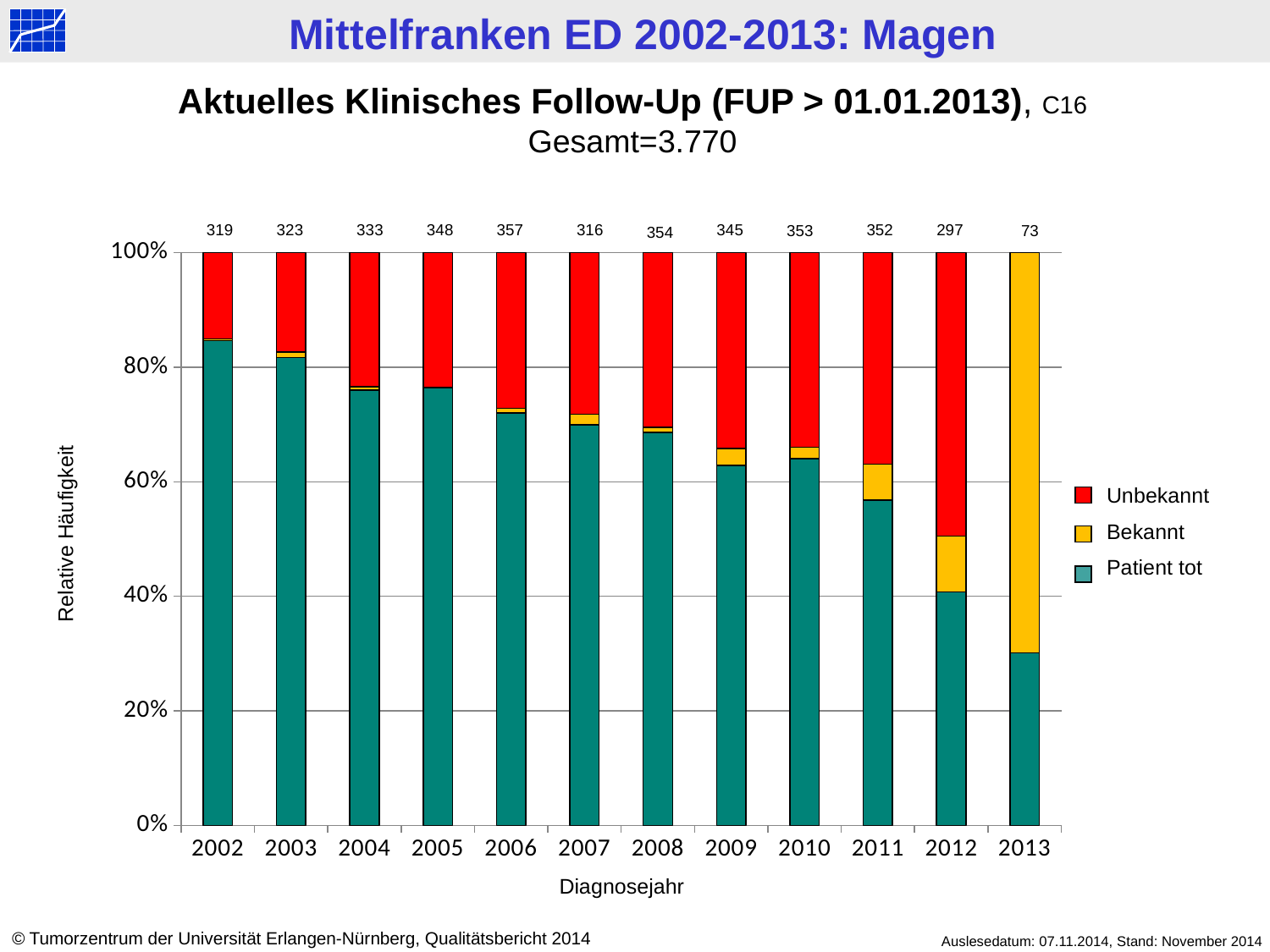
Does the share of 'Patient tot' rise or fall from 2002 to 2013? fall What is the difference between the numbers printed above the bars for 2006 and 2013? 284 Which year has the larger number printed above its bar, 2004 or 2005? 2005 What number is printed above the bar for 2006? 357 Is the share of 'Patient tot' for 2012 greater or less than 60%? less How many diagnosis years are shown on the x axis? 12 Is the share of 'Patient tot' for 2002 greater or less than 80%? greater What kind of chart is shown on the slide? Stacked bar chart Which diagnosis year has the highest number printed above its bar? 2006 How many series does the legend list? 3 What number is printed above the bar for 2013? 73 Which diagnosis year has the lowest number printed above its bar? 2013